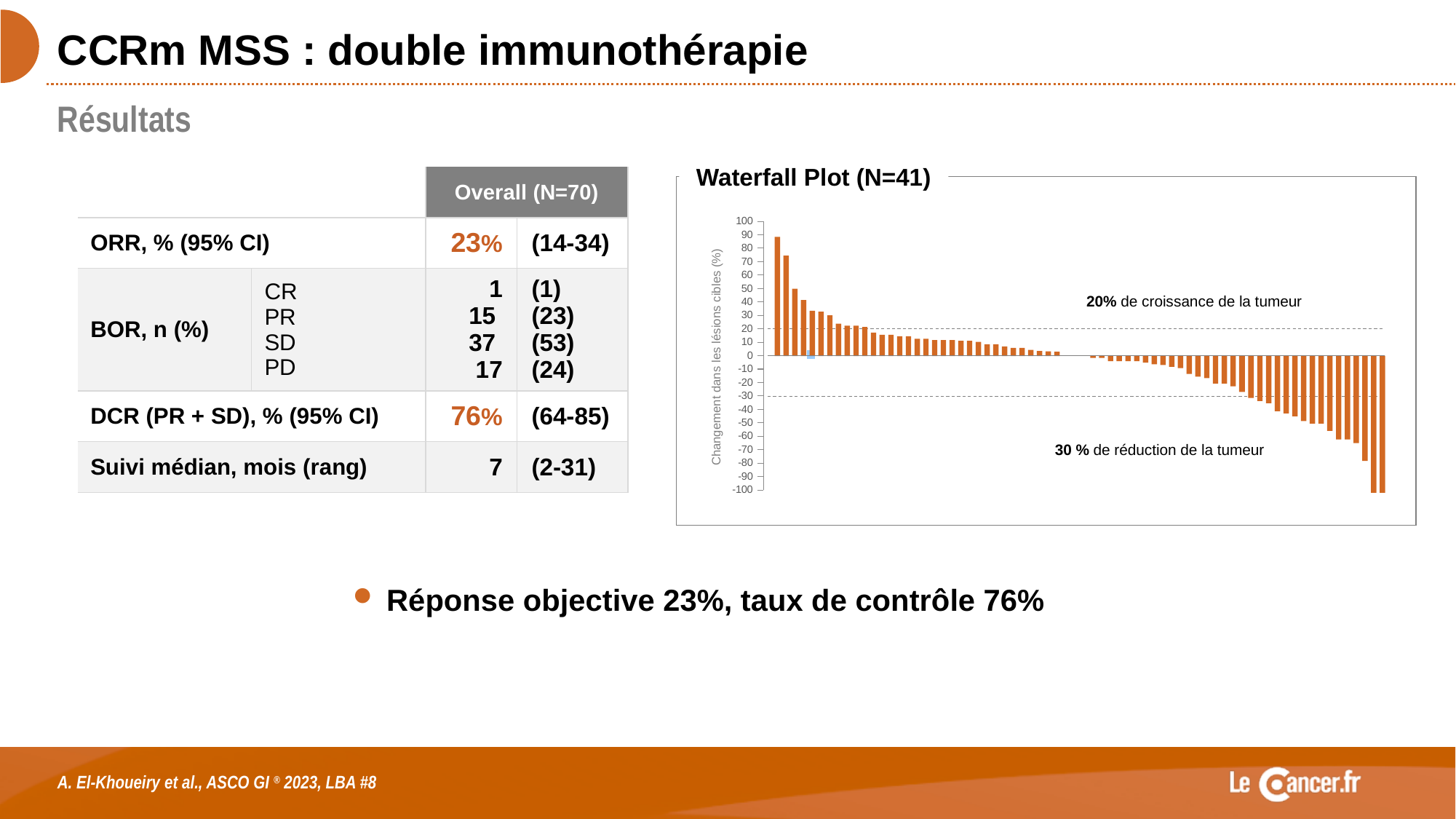
In the Waterfall Plot, do the bar values rise or fall from left to right? fall What kind of chart is the Waterfall Plot on the slide? bar chart In the Waterfall Plot, is the value of the leftmost (tallest) bar greater or less than 80? greater According to the title of the Waterfall Plot, how many patients are plotted? 41 What percentage of tumour growth does the upper dashed reference line in the Waterfall Plot mark? 20% In the Waterfall Plot, is the value of the rightmost bar greater or less than -90? less What percentage of tumour reduction does the lower dashed reference line in the Waterfall Plot mark? 30 % In the Waterfall Plot, is the value of the second bar from the left greater or less than 60? greater What is the title of the chart on the right of the slide? Waterfall Plot (N=41) What is the label of the vertical axis of the Waterfall Plot? Changement dans les lésions cibles (%) What are the minimum and maximum values shown on the vertical axis of the Waterfall Plot? -100 and 100